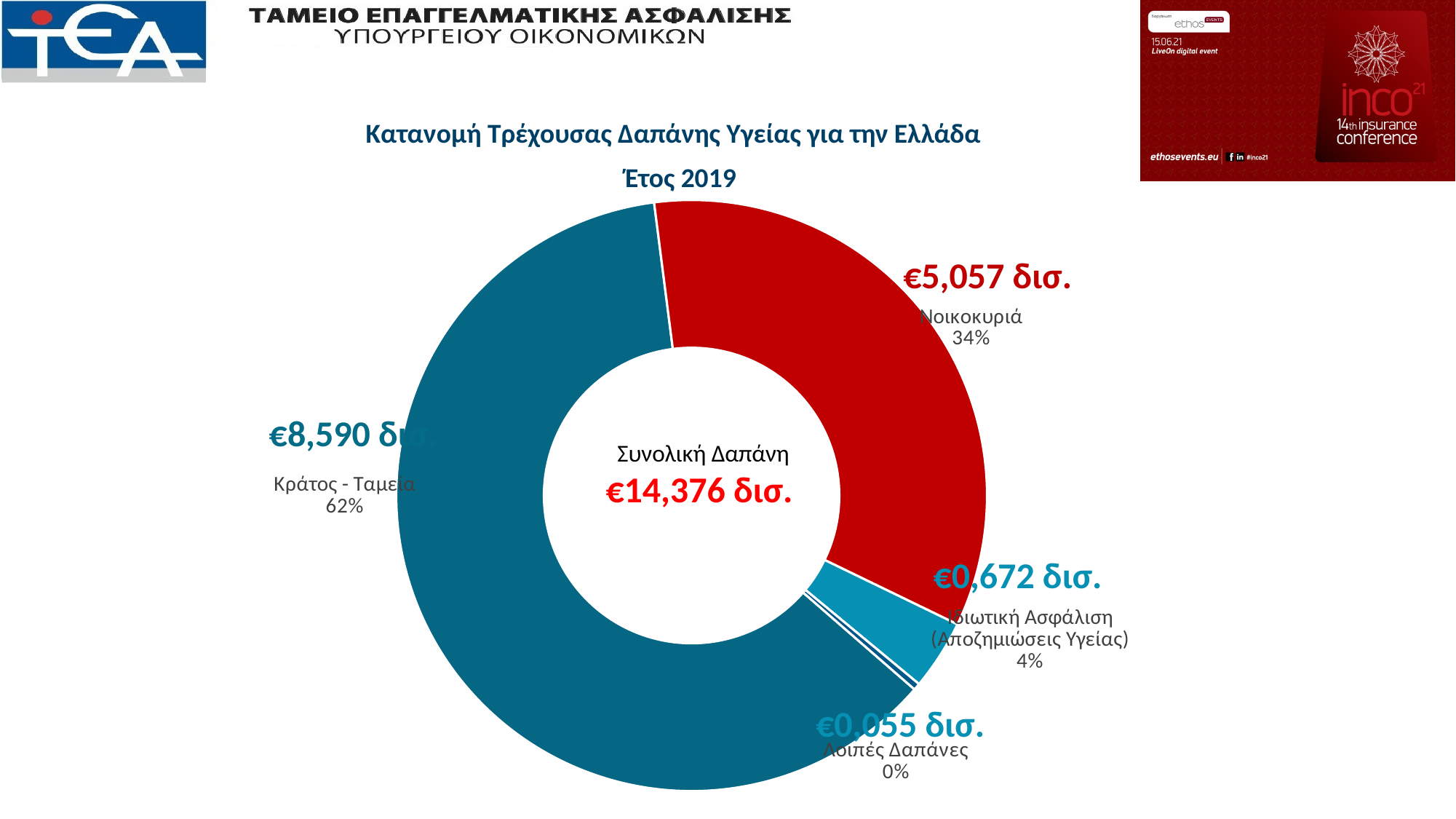
How many categories are shown in the chart? 4 What is the value shown for Νοικοκυριά? €5,057 δισ. What is the difference between the values for Κράτος - Ταμεία and Νοικοκυριά? €3,533 δισ. What is the value shown for Ιδιωτική Ασφάλιση (Αποζημιώσεις Υγείας)? €0,672 δισ. Which category has the largest share of the chart? Κράτος - Ταμεία What is the value shown for Κράτος - Ταμεία? €8,590 δισ. What percentage share does Κράτος - Ταμεία have? 62% Which category has the smallest share of the chart? Λοιπές Δαπάνες What percentage share does Νοικοκυριά have? 34% What type of chart is shown on the slide? Donut (pie) chart What is the total expenditure (Συνολική Δαπάνη) shown in the centre of the chart? €14,376 δισ. What is the value shown for Λοιπές Δαπάνες? €0.055 δισ.